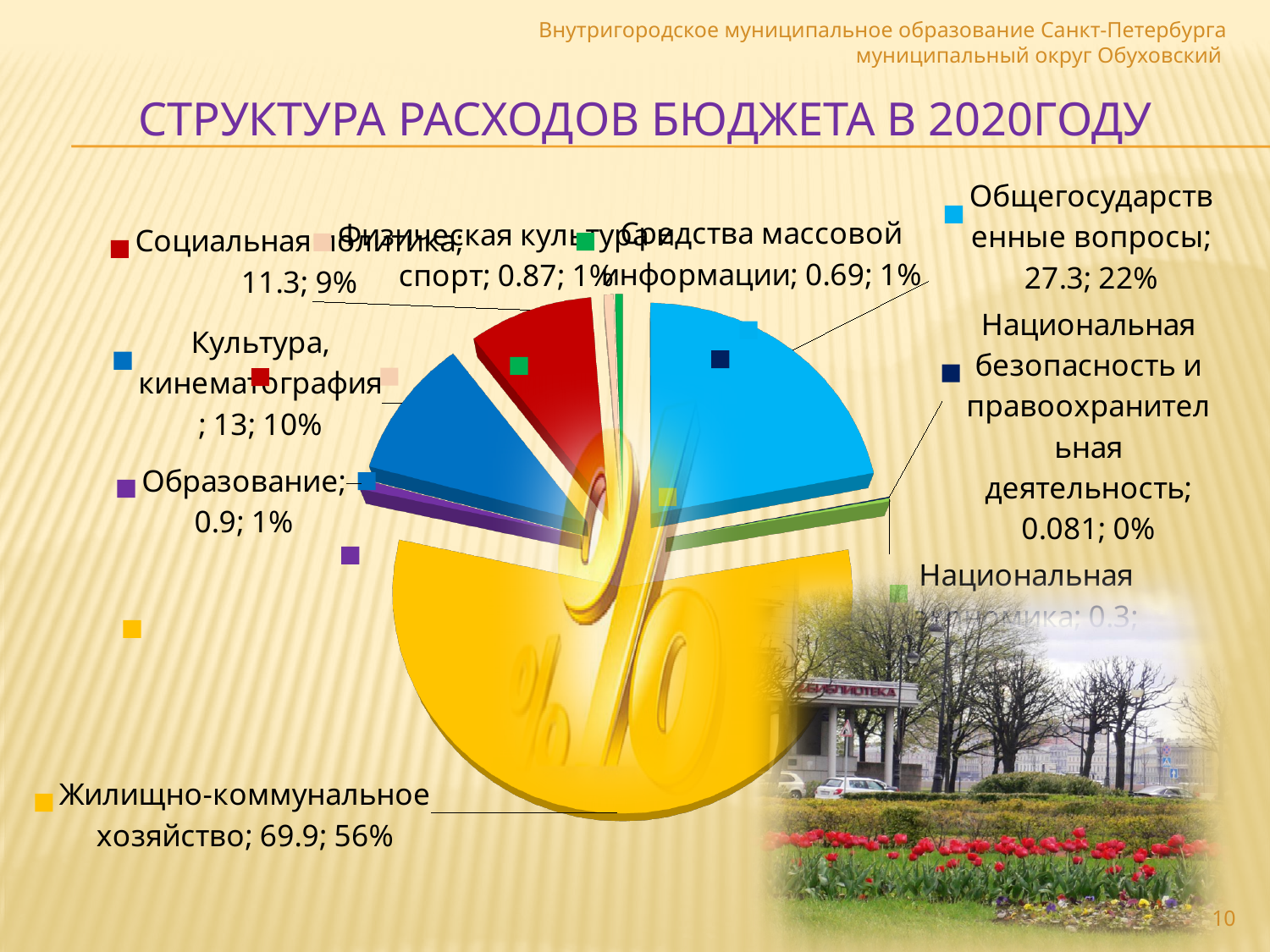
What value is shown for Культура, кинематография? 13 What is the difference between the values for Жилищно-коммунальное хозяйство and Общегосударственные вопросы? 42.6 Which category has the largest slice of the pie? Жилищно-коммунальное хозяйство What is the title of the chart on the slide? СТРУКТУРА РАСХОДОВ БЮДЖЕТА В 2020ГОДУ Which category has the smallest value in the chart? Национальная безопасность и правоохранительная деятельность What share of the pie does Общегосударственные вопросы take? 22% What kind of chart is shown on the slide? pie chart What value is shown for Жилищно-коммунальное хозяйство? 69.9 Which is larger, the value for Культура, кинематография or the value for Социальная политика? Культура, кинематография What value is shown for Национальная безопасность и правоохранительная деятельность? 0.081 What share of the pie does Жилищно-коммунальное хозяйство take? 56% What value is shown for Общегосударственные вопросы? 27.3